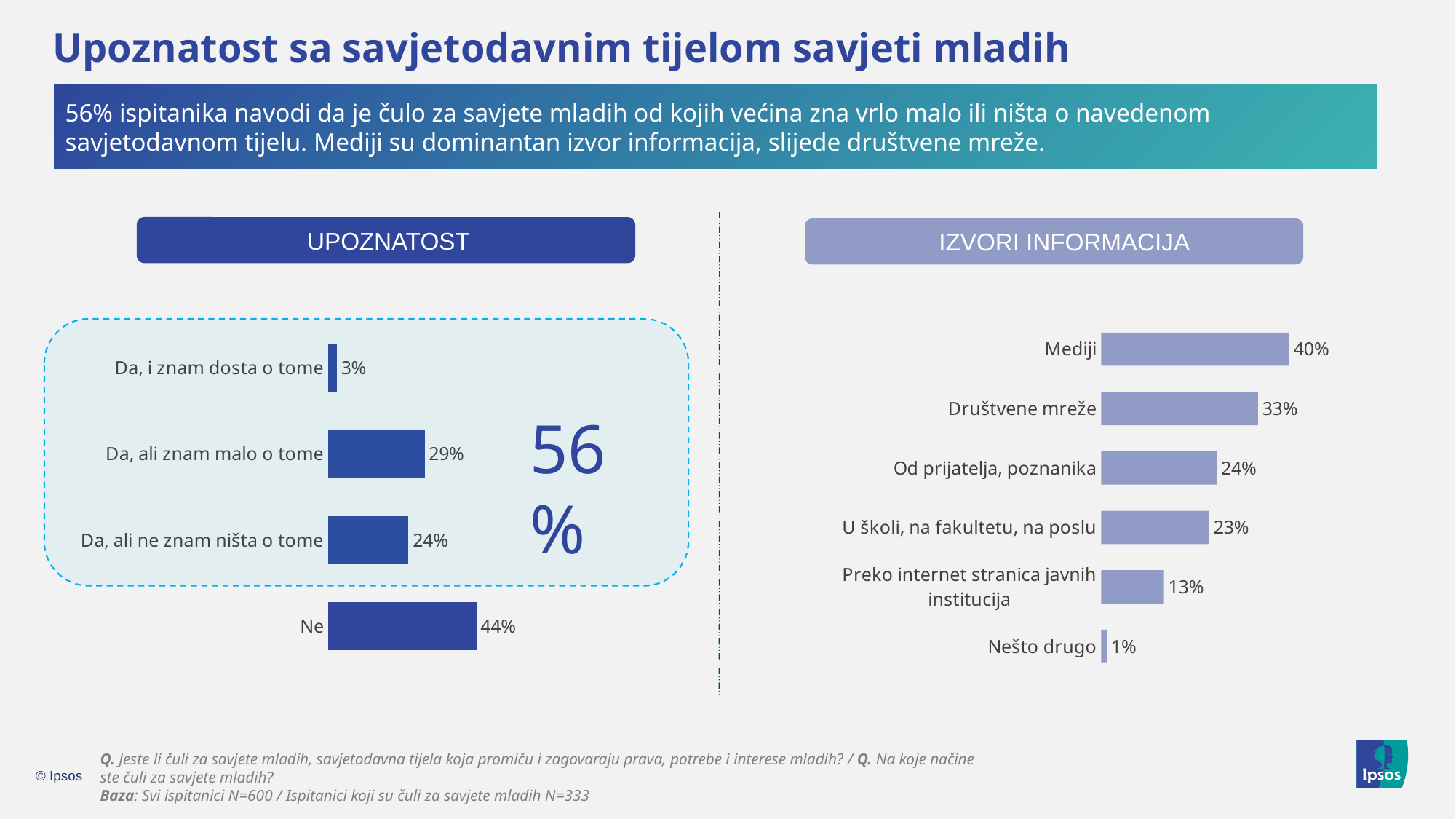
In the UPOZNATOST chart, which category has the lowest value? Da, i znam dosta o tome In the UPOZNATOST chart, how many categories are shown? 4 In the IZVORI INFORMACIJA chart, which category has the highest value? Mediji In the IZVORI INFORMACIJA chart, what is the value for "Društvene mreže"? 33% In the IZVORI INFORMACIJA chart, which is larger: "Od prijatelja, poznanika" or "U školi, na fakultetu, na poslu"? Od prijatelja, poznanika What kind of chart is the IZVORI INFORMACIJA chart? Bar chart In the UPOZNATOST chart, what total is shown for the three "Da" categories combined? 56% In the IZVORI INFORMACIJA chart, what is the difference between "Mediji" and "Preko internet stranica javnih institucija"? 27% In the UPOZNATOST chart, what is the value for "Ne"? 44% In the UPOZNATOST chart, what is the difference between "Ne" and "Da, ali ne znam ništa o tome"? 20% In the IZVORI INFORMACIJA chart, which category has the lowest value? Nešto drugo In the UPOZNATOST chart, what is the value for "Da, ali znam malo o tome"? 29%